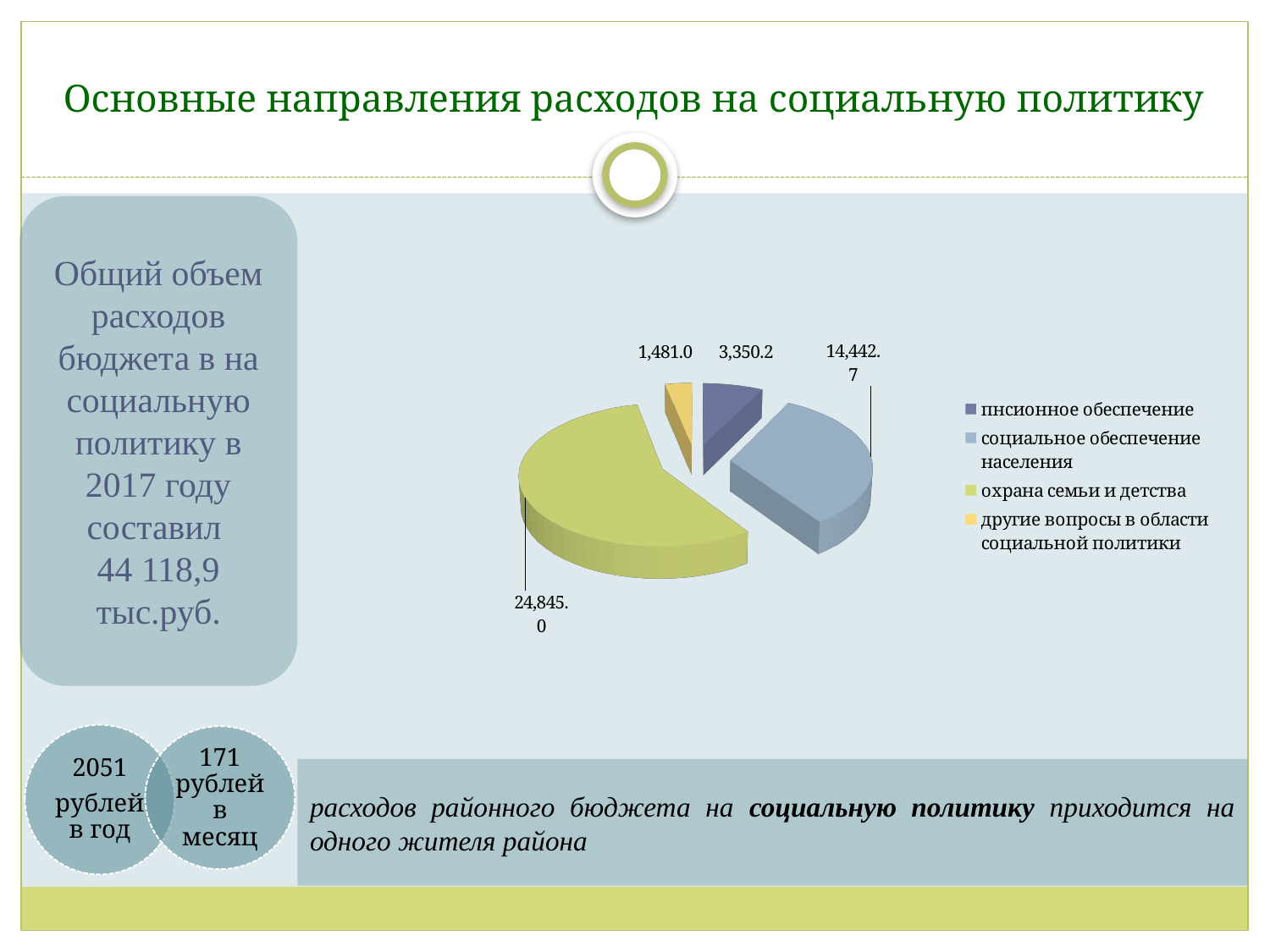
Which category has the smallest slice in the pie chart? другие вопросы в области социальной политики What type of chart is shown on the slide? Pie chart What is the value for охрана семьи и детства in the pie chart? 24,845.0 What is the value for социальное обеспечение населения in the pie chart? 14,442.7 What is the value for пнсионное обеспечение in the pie chart? 3,350.2 What is the value for другие вопросы в области социальной политики in the pie chart? 1,481.0 Which is larger: пнсионное обеспечение or социальное обеспечение населения? социальное обеспечение населения Which category has the largest slice in the pie chart? охрана семьи и детства What colour is the slice for охрана семьи и детства in the pie chart? Green How many slices does the pie chart have? 4 How many entries does the legend of the pie chart list? 4 What is the difference between the values for охрана семьи и детства and социальное обеспечение населения? 10,402.3